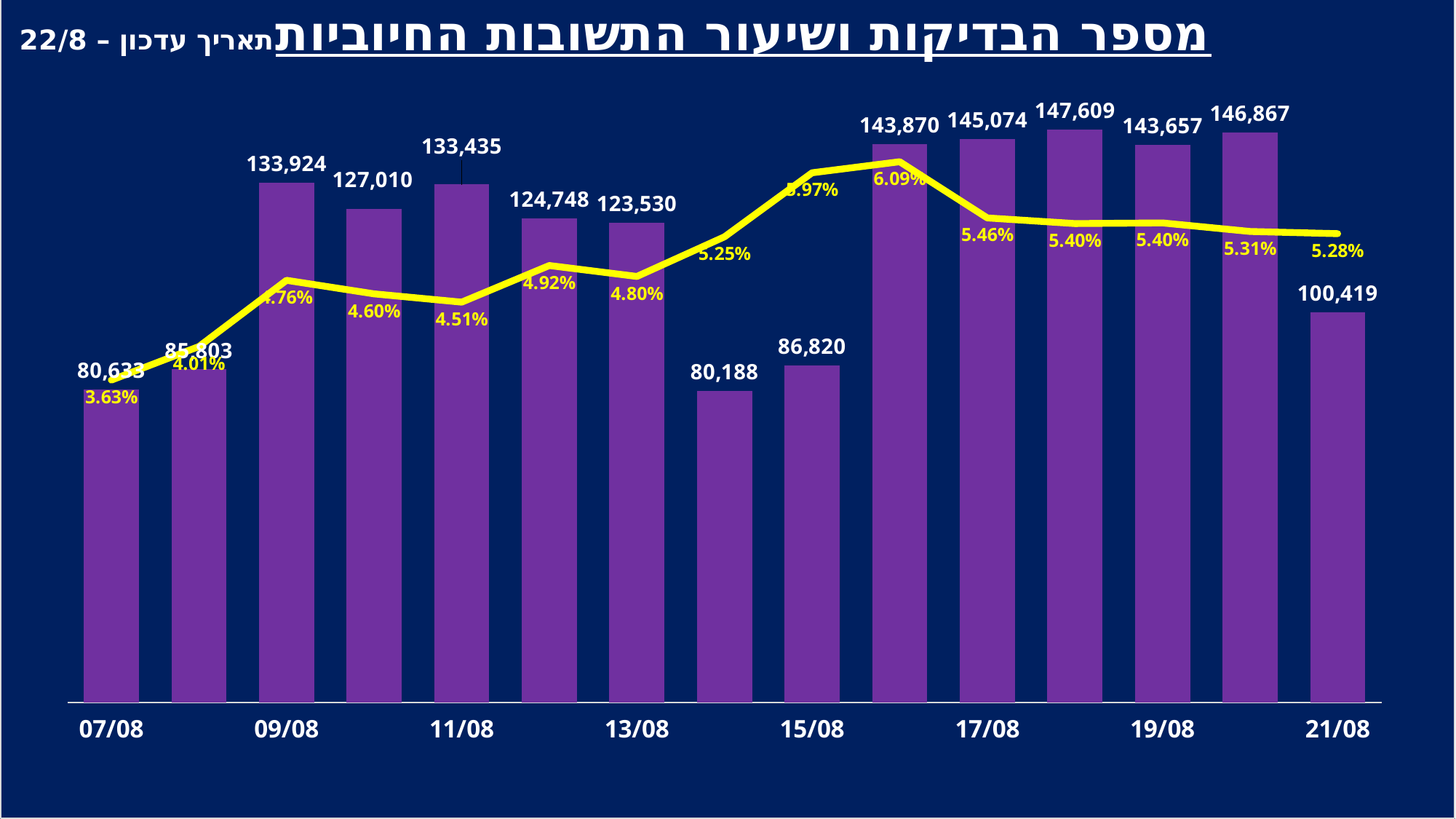
What is the highest bar value on the chart? 147,609 What is the number of tests shown for 21/08? 100,419 What is the lowest percentage shown on the yellow line? 3.63% What percentage does the yellow line show for 19/08? 5.40% What is the highest percentage shown on the yellow line? 6.09% What is the number of tests shown for 17/08? 145,074 Does the yellow line rise or fall from 07/08 to 09/08? Rise How many bars are plotted on the chart? 15 Which date has the larger bar value, 11/08 or 13/08? 11/08 What is the difference between the bar values for 19/08 and 21/08? 43,238 What percentage does the yellow line show for 07/08? 3.63% What kind of chart is shown on the slide? Bar chart with a line